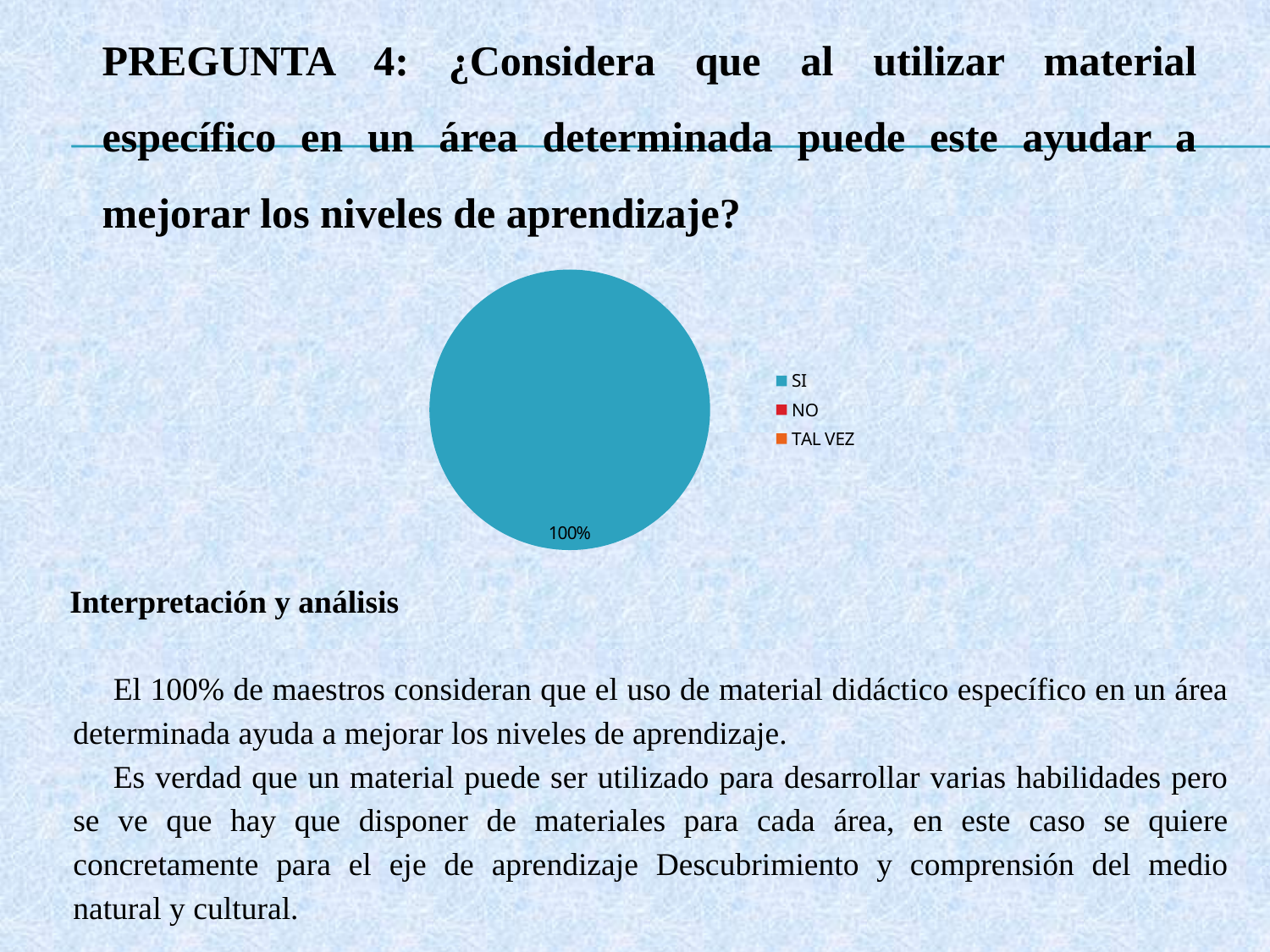
Which category is larger in the pie chart, SI or NO? SI How many entries does the chart legend list? 3 What percentage label is printed on the pie chart? 100% Is the share for SI greater or less than 50%? greater Which category accounts for the largest share of the pie? SI What share of the pie does the SI slice represent? 100% What kind of chart is shown on the slide? pie chart What are the three categories listed in the chart legend? SI, NO, TAL VEZ What colour is the SI slice in the pie chart? blue Which category is larger in the pie chart, SI or TAL VEZ? SI